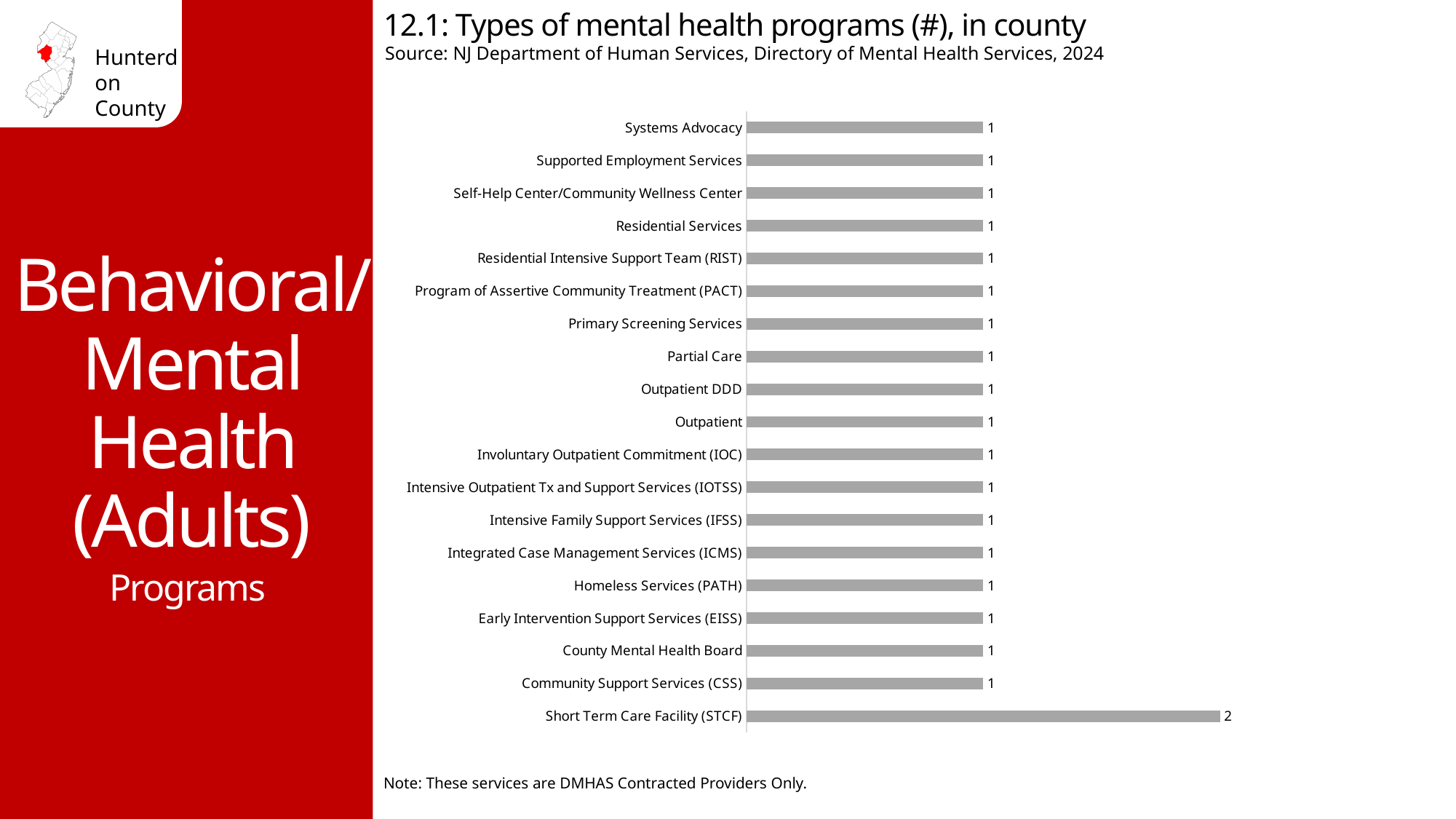
What is the difference between the number of Short Term Care Facility (STCF) programs and the number of Outpatient programs? 1 How many Short Term Care Facility (STCF) programs are there? 2 How many Partial Care programs are there? 1 What type of chart is shown on the slide? bar chart Which has more programs, Short Term Care Facility (STCF) or Community Support Services (CSS)? Short Term Care Facility (STCF) How many program types are listed in the chart? 19 What is the value for Program of Assertive Community Treatment (PACT)? 1 What is the value for Systems Advocacy? 1 Which program type has the highest number of programs? Short Term Care Facility (STCF) What source is cited for the chart? NJ Department of Human Services, Directory of Mental Health Services, 2024 What is the value for Homeless Services (PATH)? 1 What is the title of the chart? 12.1: Types of mental health programs (#), in county